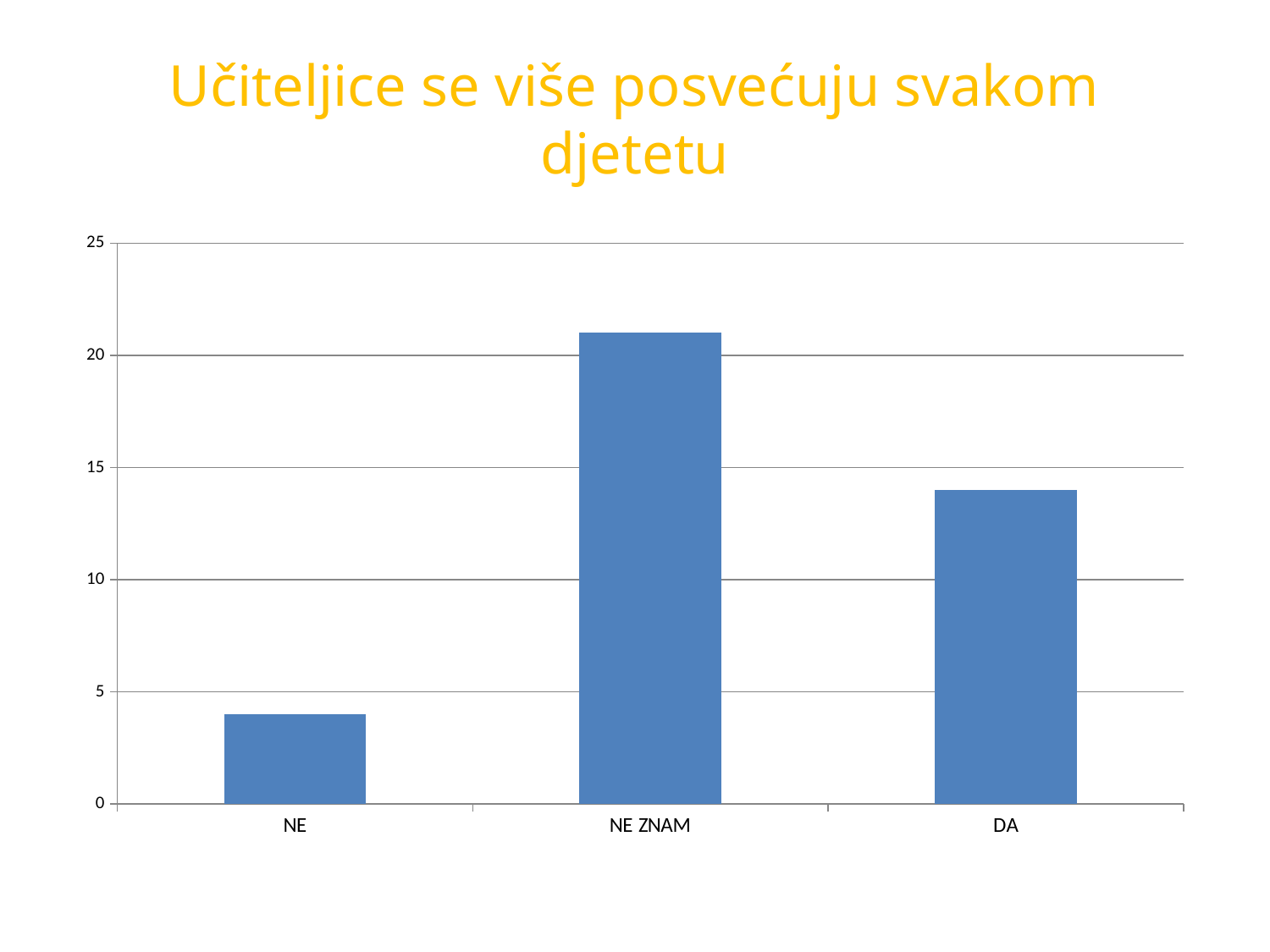
Which is larger, the value for DA or the value for NE? DA Which category has the highest bar? NE ZNAM Is the value for DA greater or less than 10? greater How many categories are shown on the x axis? 3 What kind of chart is shown on the slide? bar chart What is the title of the slide above the chart? Učiteljice se više posvećuju svakom djetetu Which category has the lowest bar? NE Is the value for NE ZNAM greater or less than 20? greater What is the highest value shown on the y axis? 25 Is the value for NE greater or less than 5? less Which is larger, the value for NE ZNAM or the value for DA? NE ZNAM